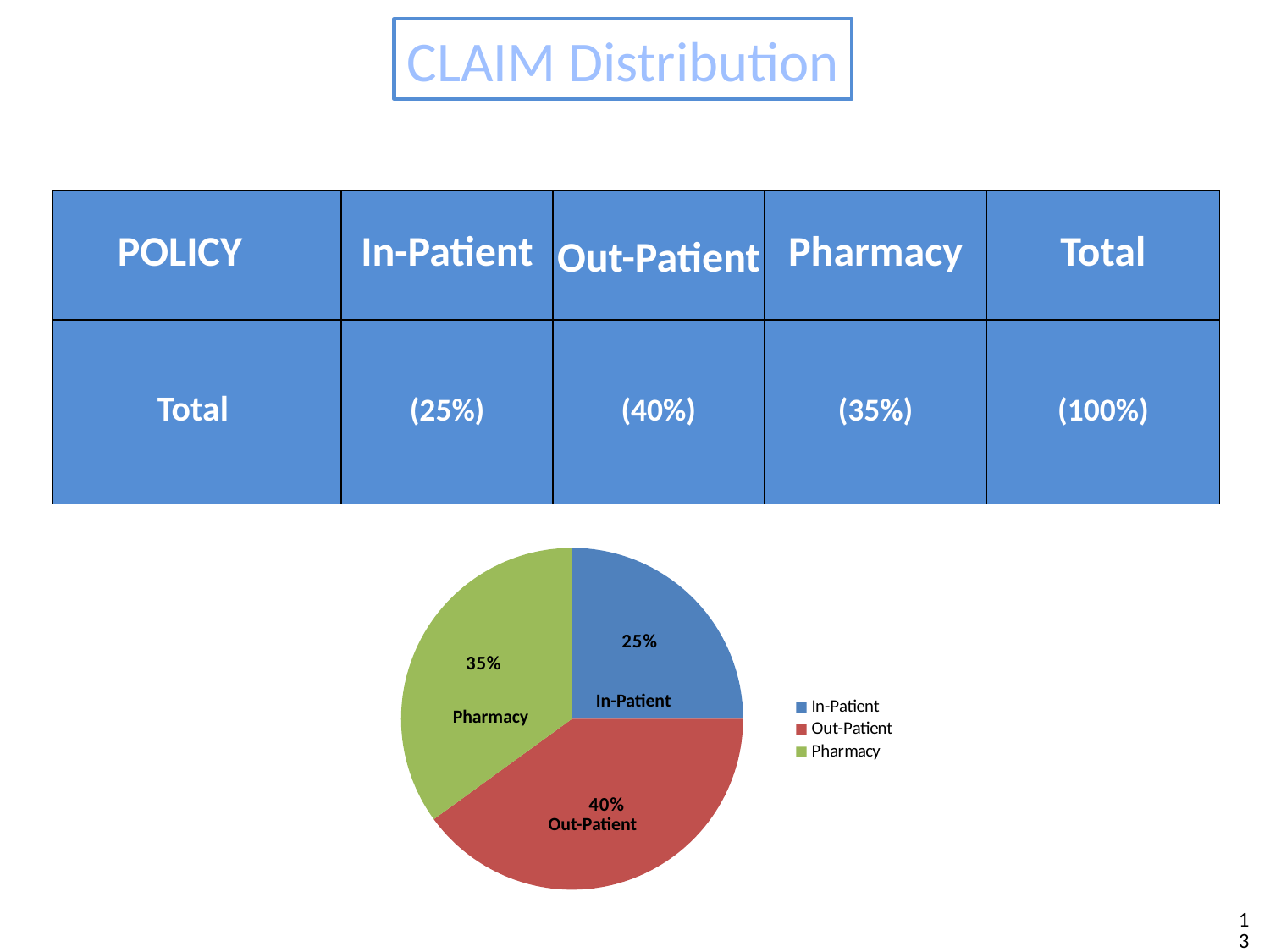
Which slice of the pie chart is the smallest? In-Patient Which is larger, the Pharmacy slice or the Out-Patient slice? Out-Patient What kind of chart is shown on the slide? pie chart What share of the pie does Out-Patient represent? 40% What colour is the Pharmacy slice in the pie chart? green What is the difference between the Out-Patient and In-Patient shares? 15% How many entries does the legend list? 3 What share of the pie does In-Patient represent? 25% Which slice of the pie chart is the largest? Out-Patient What is the difference between the Pharmacy and In-Patient shares? 10% How many slices does the pie chart have? 3 What share of the pie does Pharmacy represent? 35%